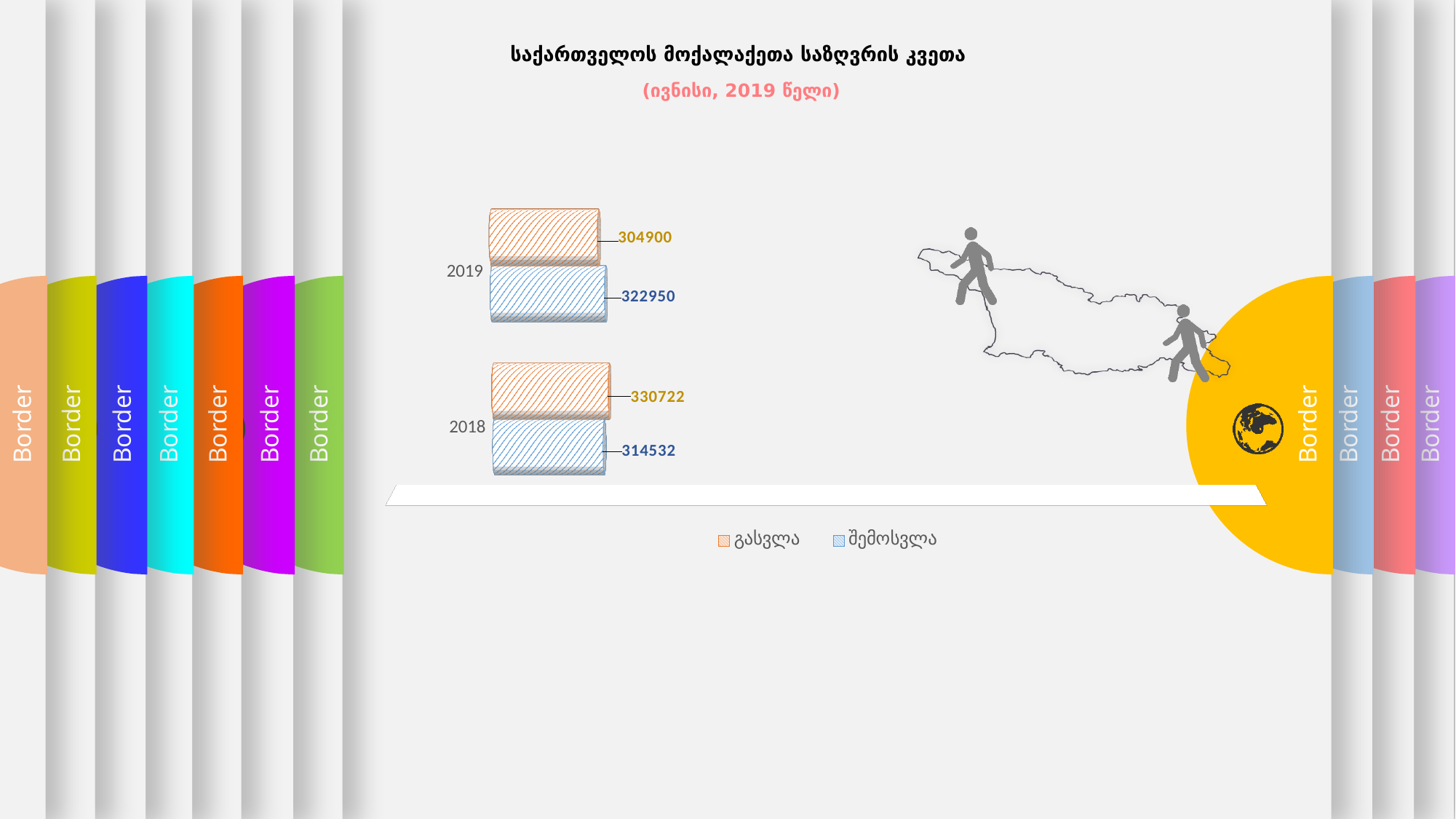
What is the value for შემოსვლა in 2019? 322950 Which year has the higher value for გასვლა? 2018 What is the difference between გასვლა and შემოსვლა in 2018? 16190 How many series does the legend list? 2 What is the value for შემოსვლა in 2018? 314532 Which year has the lower value for შემოსვლა? 2018 In 2019, which is larger: გასვლა or შემოსვლა? შემოსვლა What is the difference between შემოსვლა and გასვლა in 2019? 18050 How many years are shown on the chart? 2 What is the value for გასვლა in 2018? 330722 What is the value for გასვლა in 2019? 304900 What kind of chart is shown on the slide? Bar chart